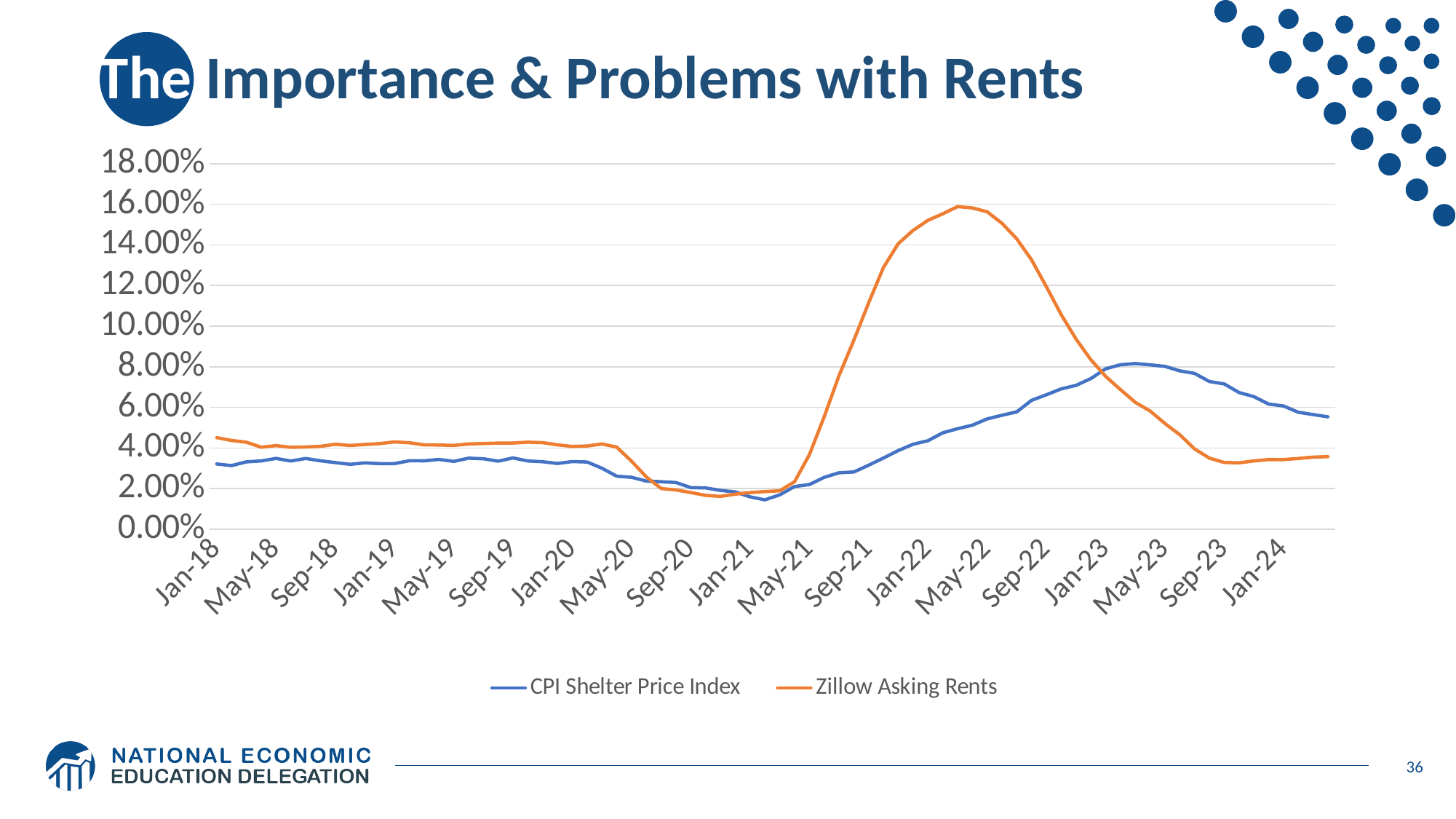
How many series does the legend list? 2 What is the title of the slide containing the chart? The Importance & Problems with Rents Does the Zillow Asking Rents line rise or fall between May-22 and Sep-23? Fall Is the value for Zillow Asking Rents at May-22 greater or less than 14.00%? greater Is the value for Zillow Asking Rents at Sep-23 greater or less than 4.00%? less Which series reaches the highest peak on the chart? Zillow Asking Rents Is the value for CPI Shelter Price Index at Jan-23 greater or less than 6.00%? greater What kind of chart is shown on the slide? Line chart At May-23, which series has the higher value, CPI Shelter Price Index or Zillow Asking Rents? CPI Shelter Price Index How many date labels are shown on the x axis? 19 Which series is drawn in orange? Zillow Asking Rents